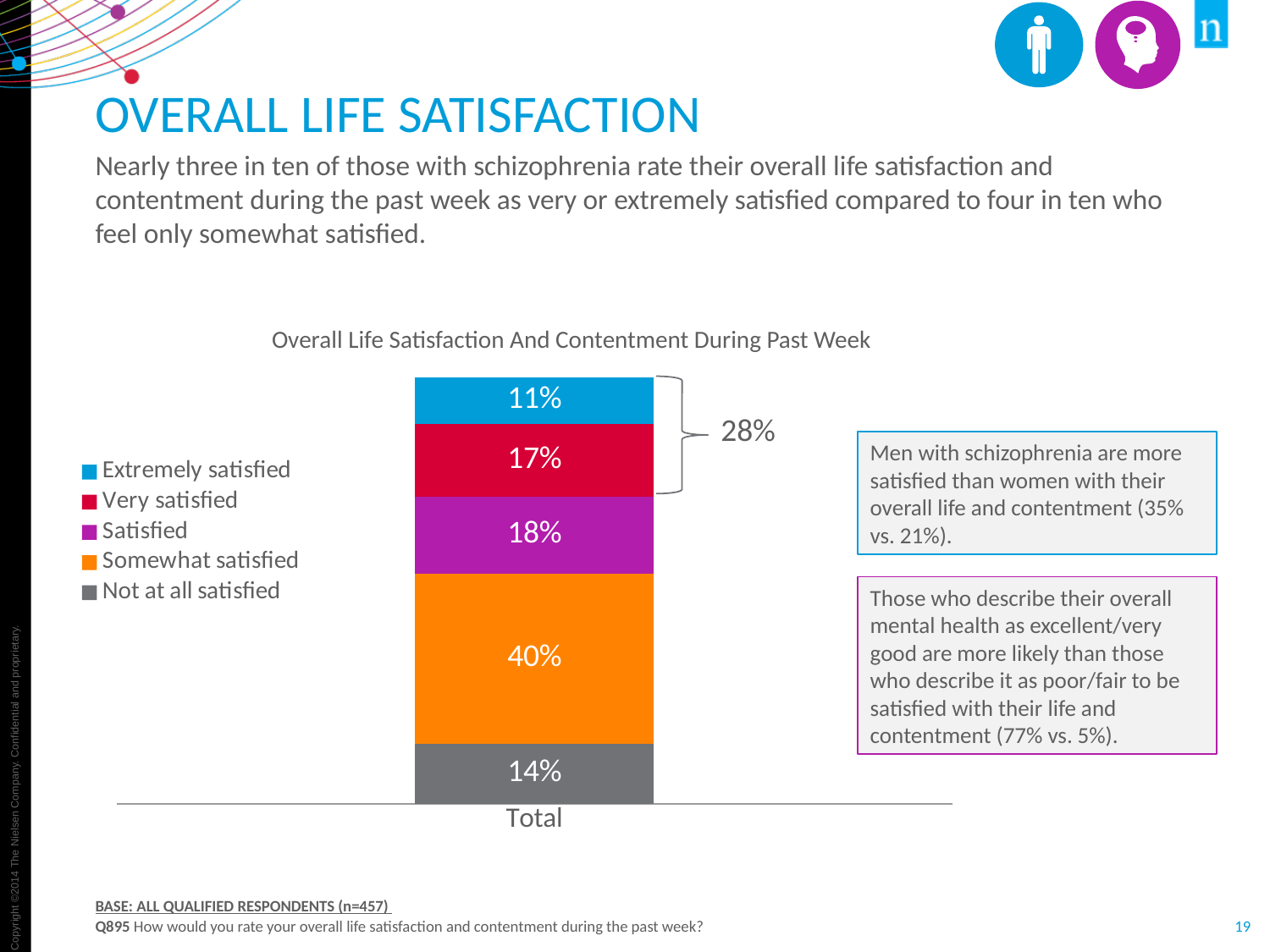
What is the value for Extremely satisfied in the Total bar? 11% Which series has the largest segment in the Total bar? Somewhat satisfied What kind of chart is shown on the slide? Stacked bar chart What is the value for Somewhat satisfied in the Total bar? 40% What is the title of the chart? Overall Life Satisfaction And Contentment During Past Week Which is larger, the Very satisfied value or the Not at all satisfied value? Very satisfied Which series has the smallest segment in the Total bar? Extremely satisfied How many series does the legend list? 5 What is the value for Very satisfied in the Total bar? 17% What is the difference between the Somewhat satisfied and Satisfied values? 22% What is the combined value shown by the bracket for Extremely satisfied and Very satisfied? 28% What is the value for Not at all satisfied in the Total bar? 14%